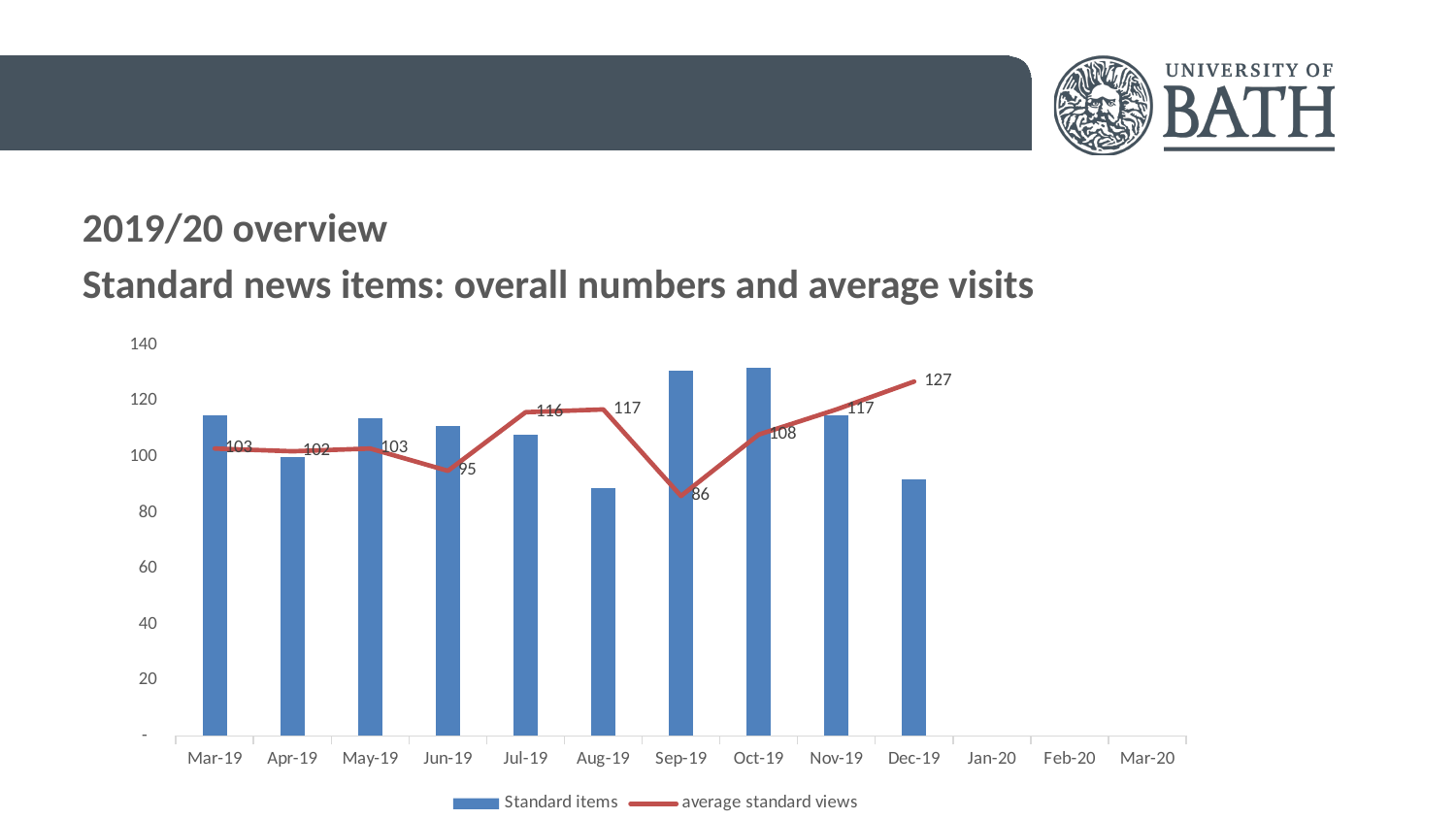
What is the average standard views value for Sep-19? 86 Is the Standard items value for Aug-19 greater or less than 100? less Which month has the lowest average standard views? Sep-19 Is the Standard items value for Oct-19 greater or less than 120? greater What is the average standard views value for Dec-19? 127 What is the average standard views value for Jun-19? 95 Which month has higher average standard views, Jun-19 or Jul-19? Jul-19 Does the average standard views line rise or fall from Sep-19 to Dec-19? rise How many months have a Standard items bar plotted? 10 What is the difference between the average standard views in Dec-19 and Sep-19? 41 Which month has the highest average standard views? Dec-19 How many series does the legend list? 2